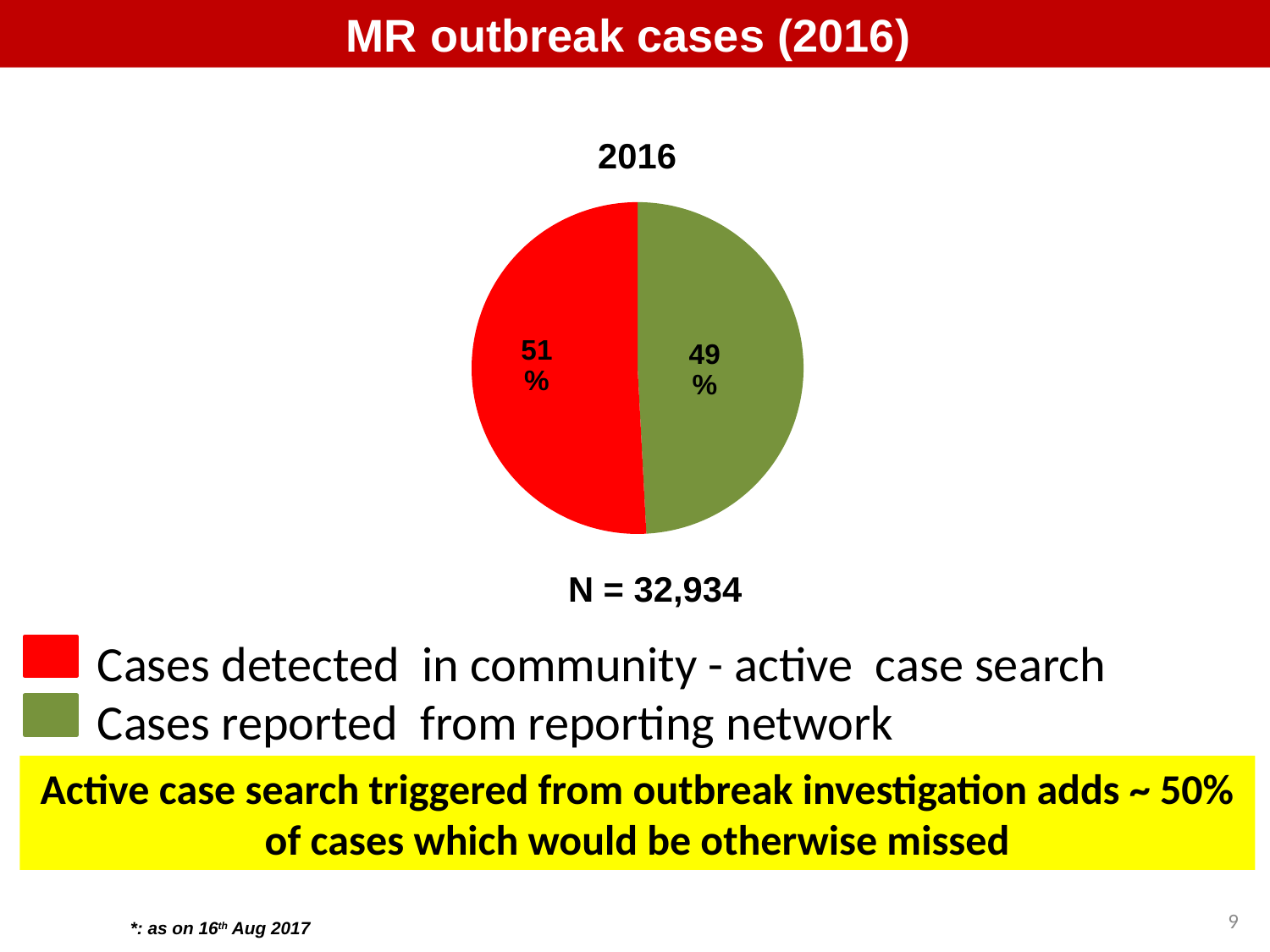
Which category has the larger share of the pie? Cases detected in community - active case search What is the total number of cases (N) shown below the chart? 32,934 What is the chart's title? 2016 What percentage of cases were detected in community through active case search? 51% How many slices does the pie chart have? 2 What kind of chart is shown on the slide? pie chart How many entries does the legend list? 2 Which colour represents cases reported from the reporting network? green Which category has the smaller share of the pie? Cases reported from reporting network What is the difference in percentage points between cases detected in community and cases reported from the reporting network? 2 What percentage of cases were reported from the reporting network? 49% Is the share for cases detected in community larger or smaller than the share for cases reported from the reporting network? larger